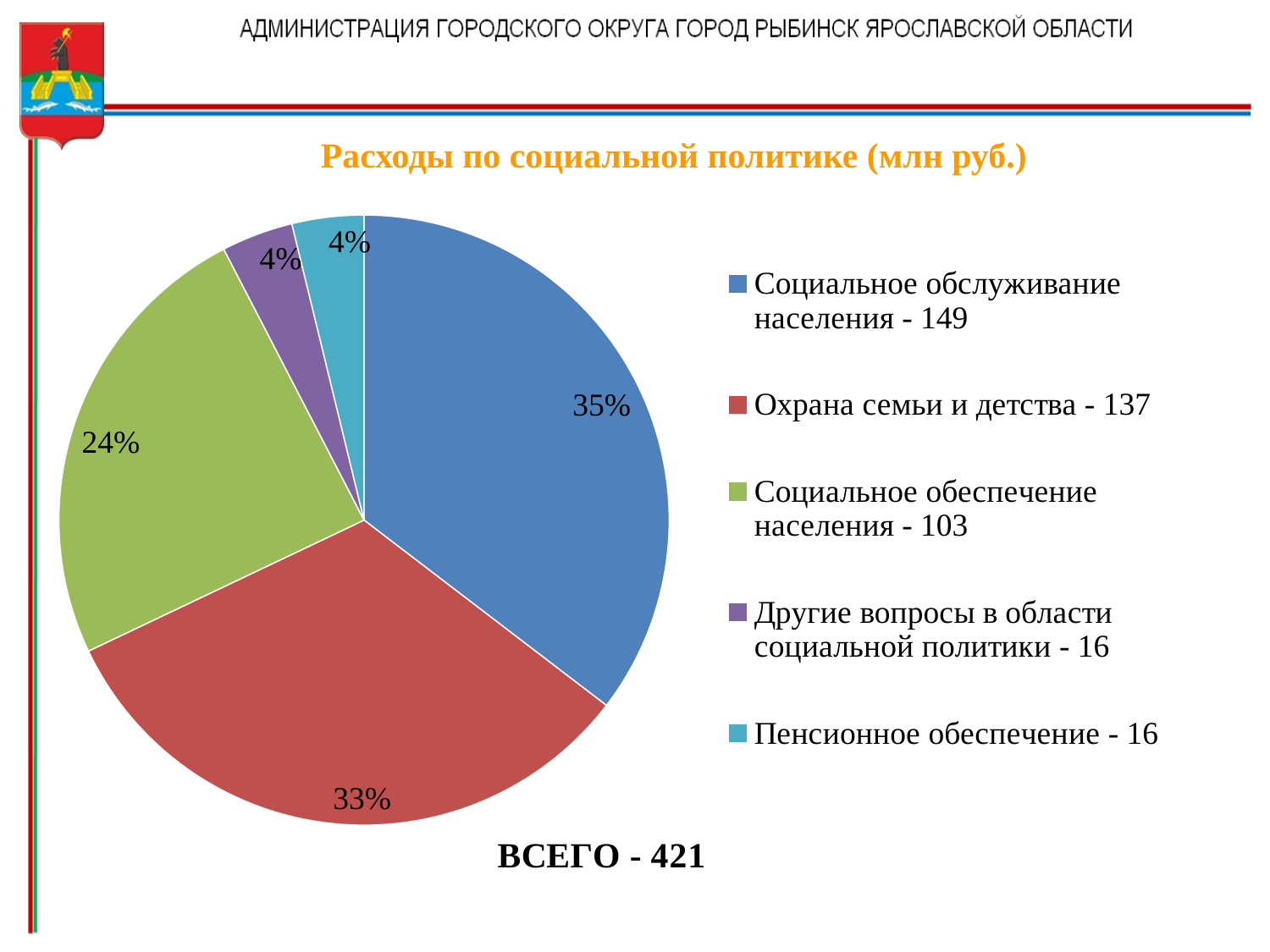
What is the title of the chart? Расходы по социальной политике (млн руб.) What value is given in the legend for "Пенсионное обеспечение"? 16 What value is given in the legend for "Социальное обеспечение населения"? 103 What is the difference between the values for "Социальное обслуживание населения" and "Охрана семьи и детства"? 12 What share of the pie does "Социальное обслуживание населения" take? 35% Which category has the largest slice of the pie? Социальное обслуживание населения Which is larger: the value for "Охрана семьи и детства" or for "Социальное обеспечение населения"? Охрана семьи и детства What share of the pie does "Социальное обеспечение населения" take? 24% How many slices does the pie chart have? 5 What kind of chart is shown on the slide? pie chart What total (ВСЕГО) is shown below the chart? 421 What share of the pie does "Охрана семьи и детства" take? 33%